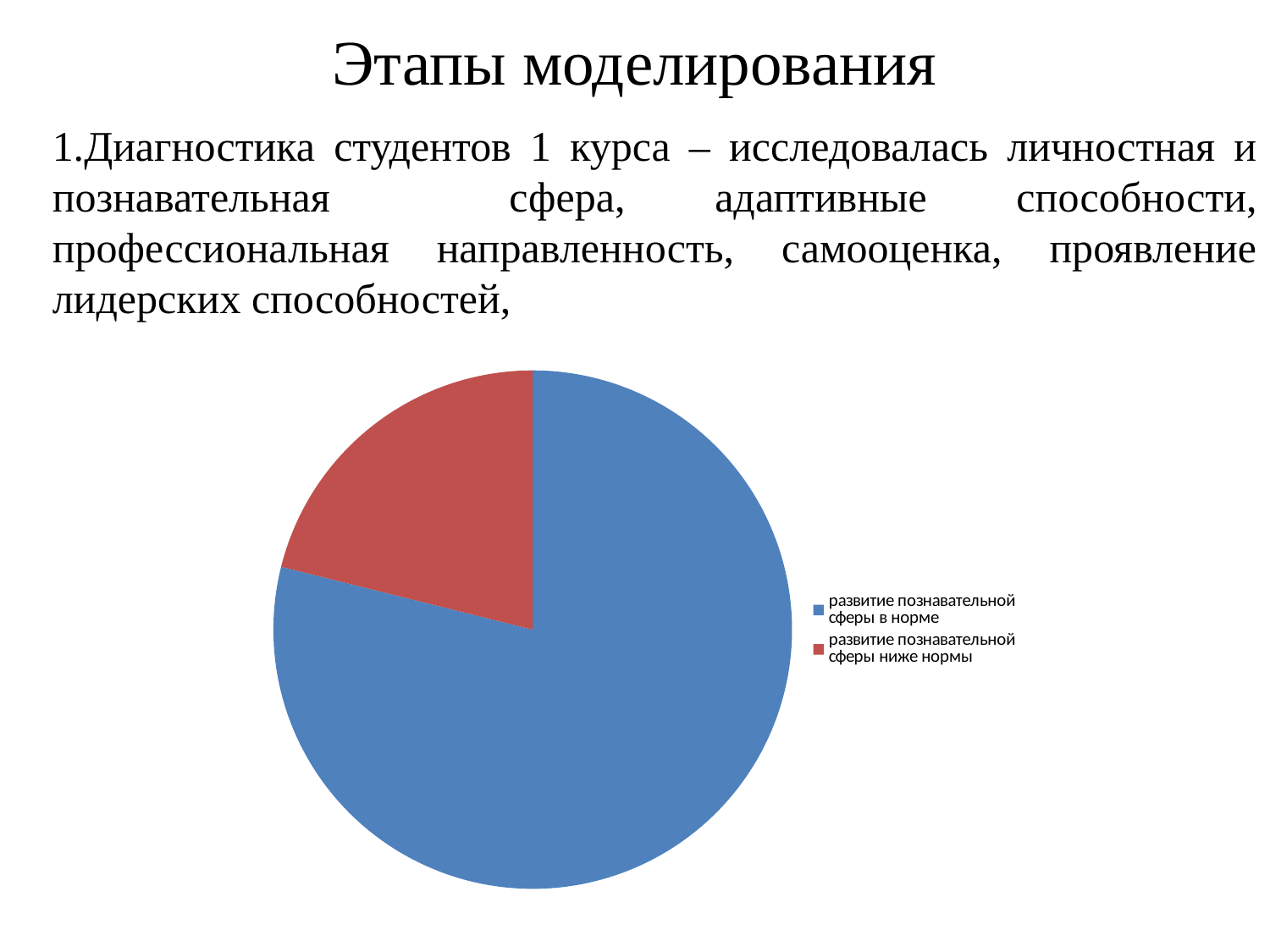
What kind of chart is shown on the slide? pie chart What colour is the slice for 'развитие познавательной сферы в норме'? blue How many slices does the pie chart have? 2 Which slice is larger: 'развитие познавательной сферы в норме' or 'развитие познавательной сферы ниже нормы'? развитие познавательной сферы в норме Which category has the largest slice in the pie chart? развитие познавательной сферы в норме What colour is the slice for 'развитие познавательной сферы ниже нормы'? red How many entries does the legend of the pie chart list? 2 Which category has the smallest slice in the pie chart? развитие познавательной сферы ниже нормы